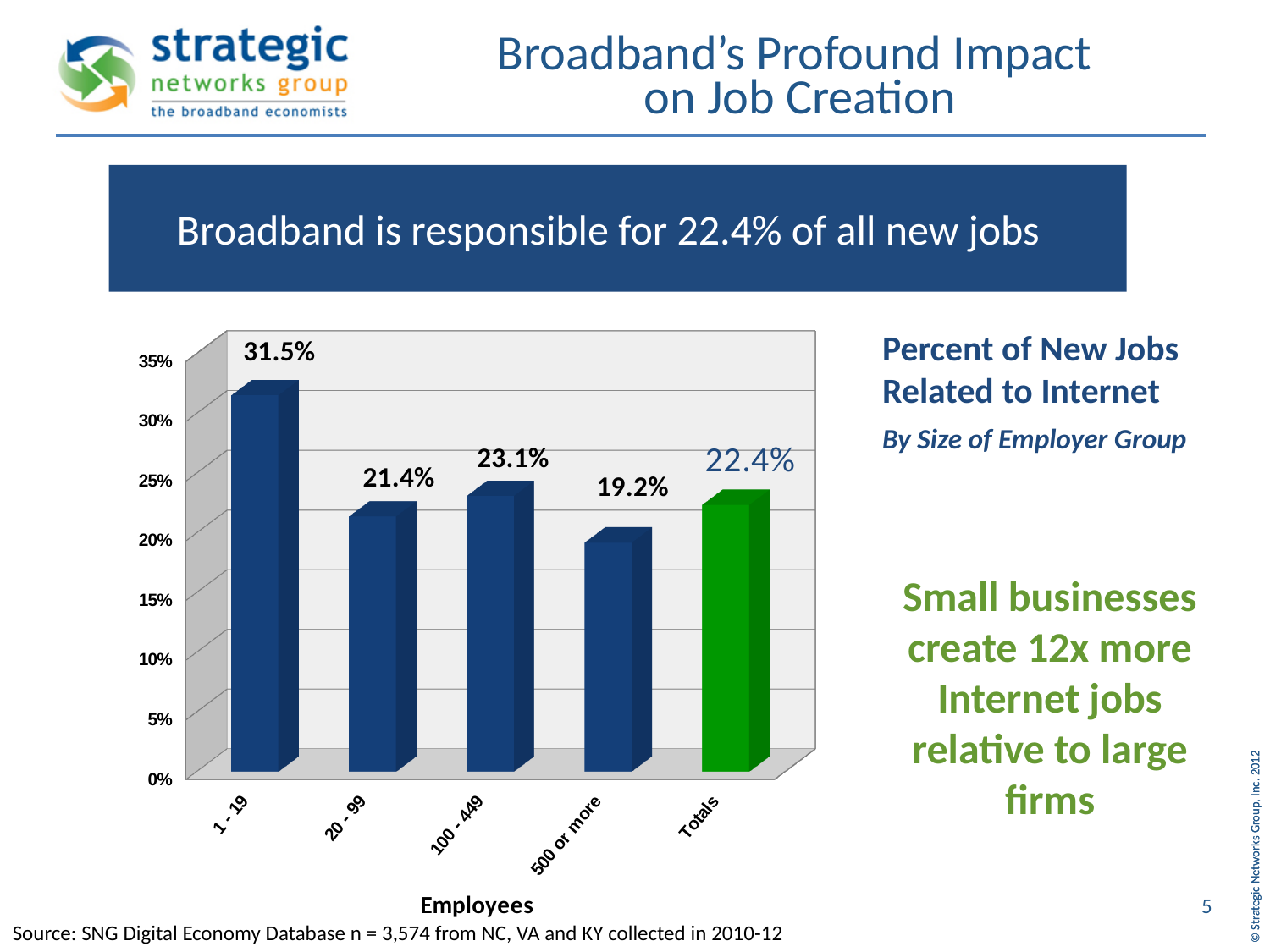
What is the value for the Totals bar? 22.4% What is the value for the 500 or more employees category? 19.2% Which is larger, the value for 100 - 449 or the value for 20 - 99? 100 - 449 What is the label of the x axis of the chart? Employees What is the value for the 1 - 19 employees category? 31.5% How many bars are shown in the chart? 5 What is the difference between the values for 1 - 19 and 500 or more employees? 12.3% Which employer size group has the highest percent of new jobs related to Internet? 1 - 19 Is the value for 20 - 99 employees greater or less than 25%? less What is the difference between the values for 100 - 449 and 20 - 99 employees? 1.7% What kind of chart is shown on the slide? bar chart Which employer size group has the lowest percent of new jobs related to Internet? 500 or more